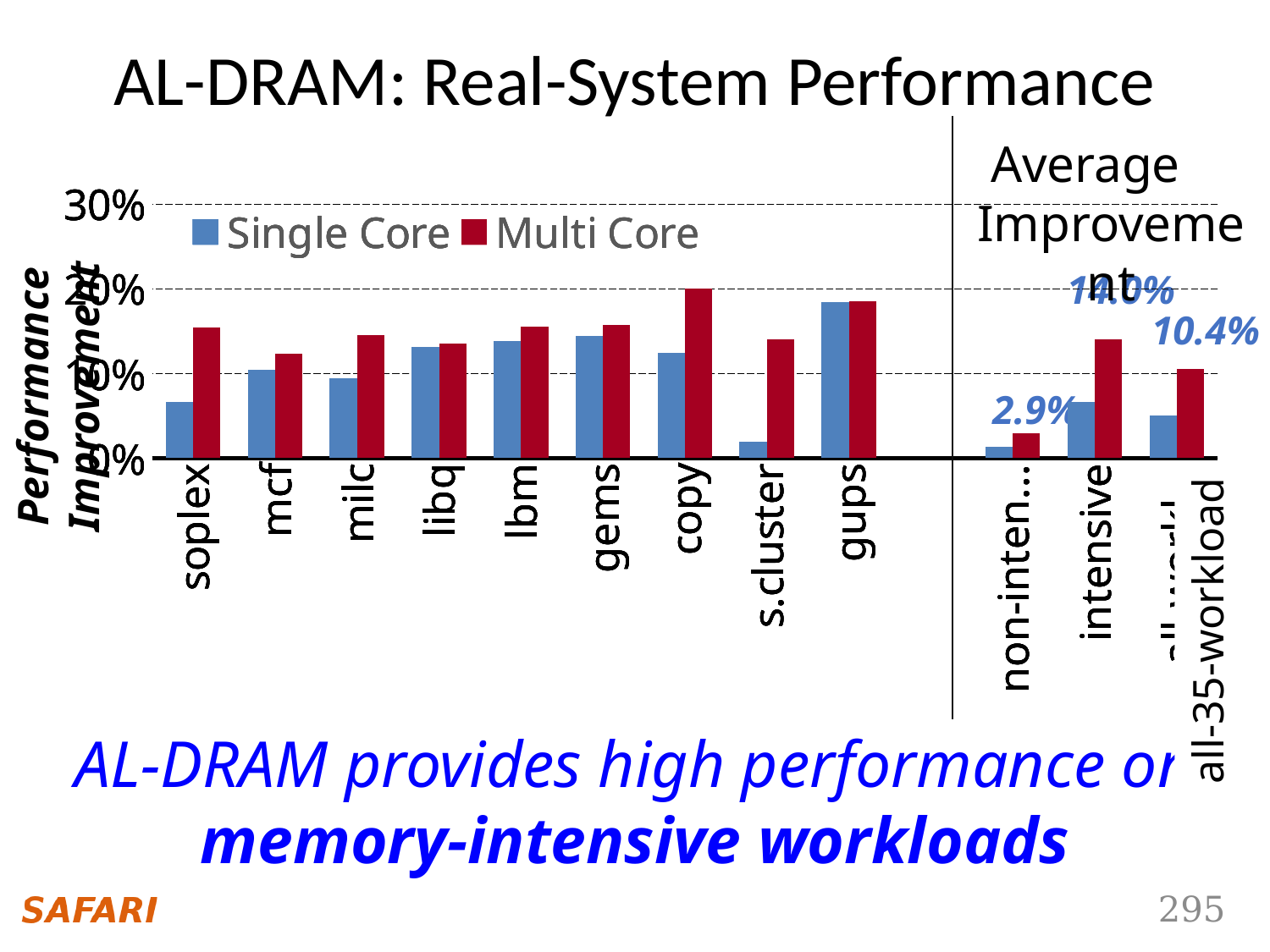
For s.cluster, which is larger: the Single Core or the Multi Core performance improvement? Multi Core Which category has the lowest Multi Core performance improvement? non-intensive Is the Single Core performance improvement for s.cluster greater or less than 10%? less What is the Multi Core performance improvement for the all-35-workload average? 10.4% What is the Multi Core performance improvement for the intensive average? 14.0% What are the two series named in the legend? Single Core and Multi Core What is the Multi Core performance improvement for the non-intensive average? 2.9% How many series does the legend list? 2 Is the Single Core performance improvement for gups greater or less than 10%? greater Which workload has the highest Single Core performance improvement? gups What type of chart is shown on the slide? bar chart What colour represents the Multi Core series? red